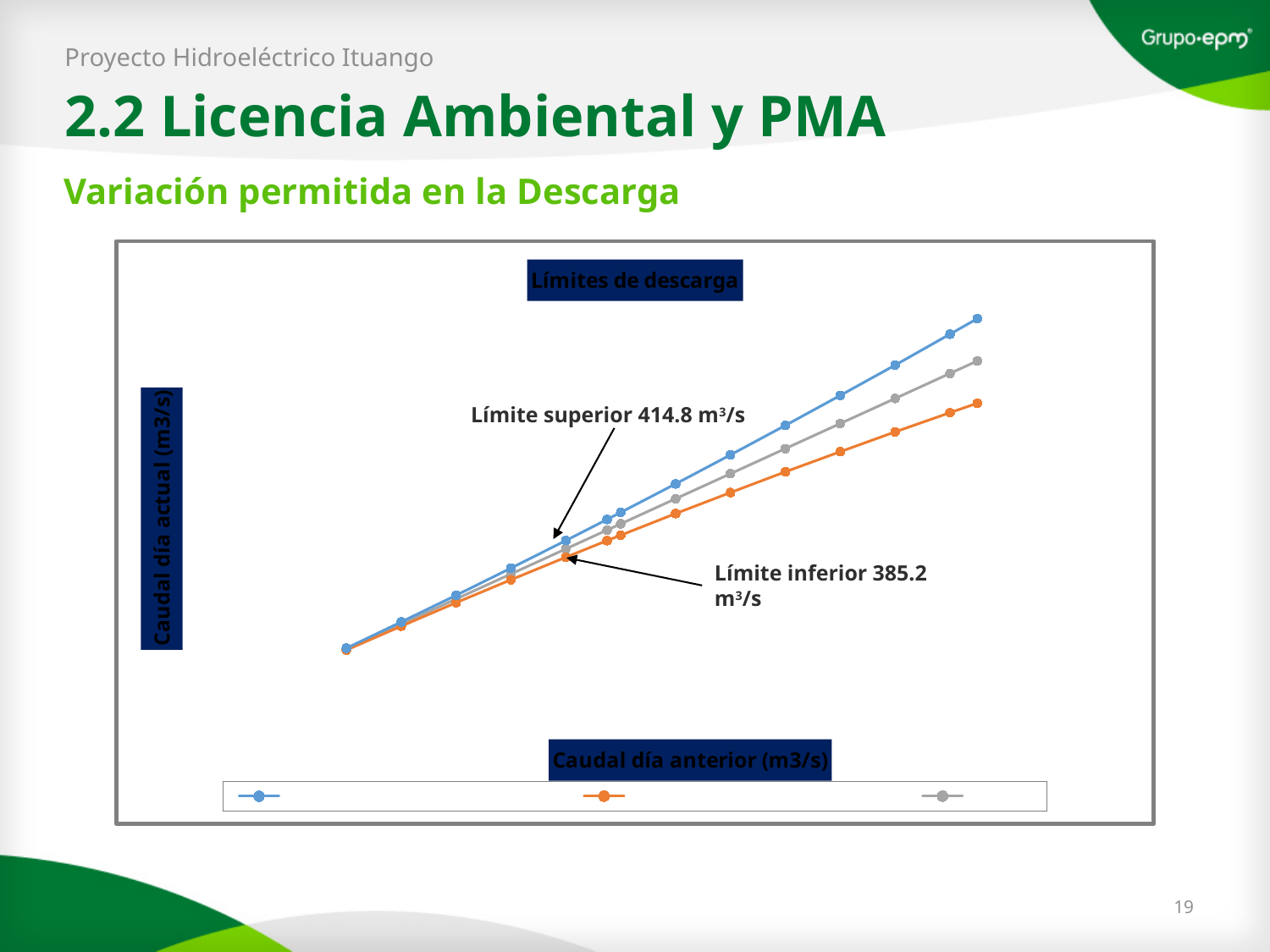
What is the title of the chart? Límites de descarga What kind of chart is shown on the slide? line chart Which coloured line reaches the highest value at the right end of the chart? the blue line Do the lines in the chart rise or fall as the x axis (Caudal día anterior) increases? rise What value is given for the 'Límite superior' annotation on the chart? 414.8 m³/s What value is given for the 'Límite inferior' annotation on the chart? 385.2 m³/s Which coloured line has the lowest value at the right end of the chart? the orange line At the right end of the chart, is the blue line above or below the gray line? above Which is larger, the 'Límite superior' value or the 'Límite inferior' value annotated on the chart? Límite superior What is the label of the vertical axis of the chart? Caudal día actual (m3/s) What is the difference between the 'Límite superior' and the 'Límite inferior' values annotated on the chart? 29.6 m³/s How many series does the legend of the chart list? 3